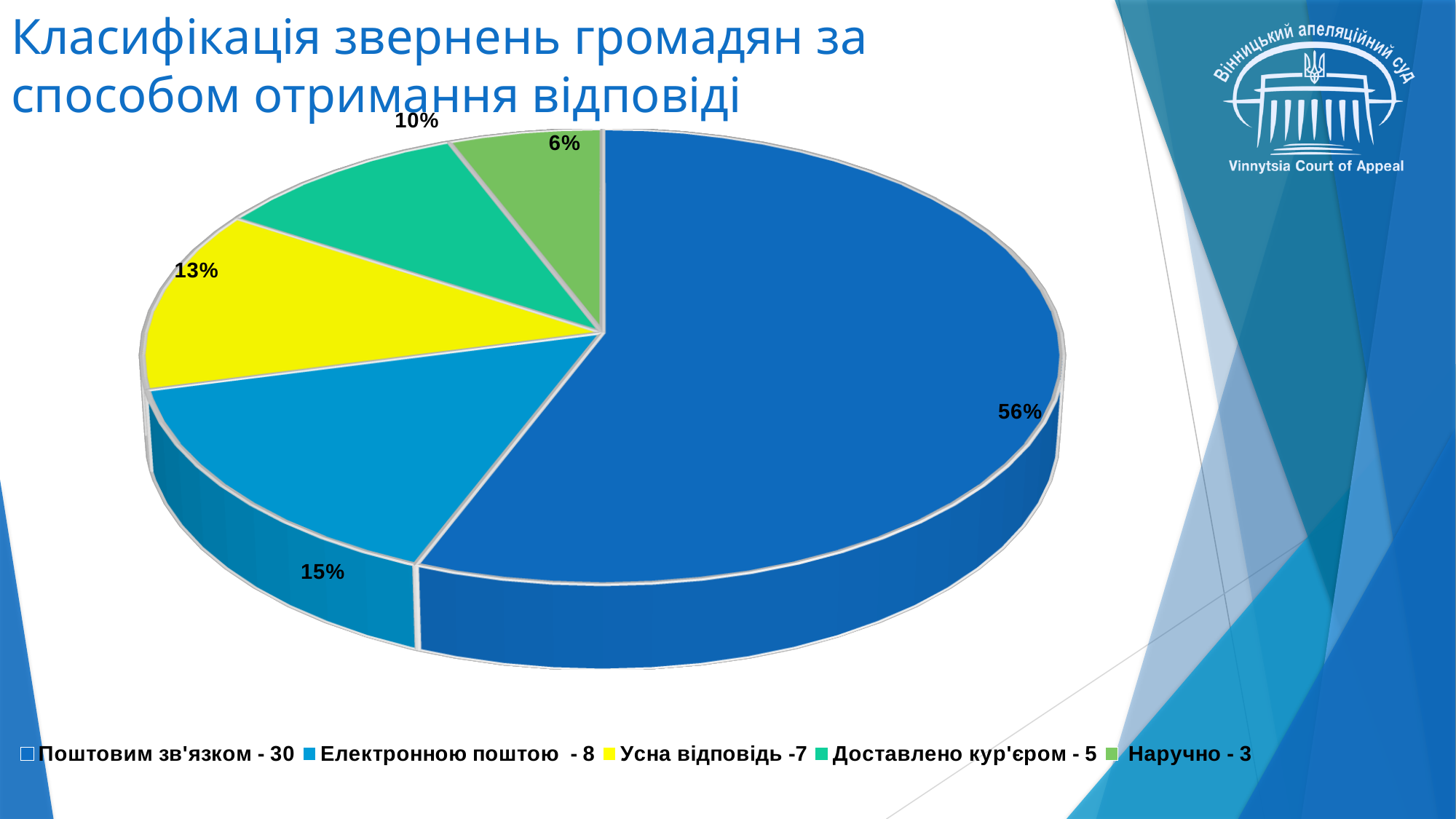
What percentage share is shown for the slice "Доставлено кур'єром"? 10% What percentage share is shown for the slice "Поштовим зв'язком"? 56% What kind of chart is shown on the slide? pie chart What is the difference in percentage points between the shares of "Поштовим зв'язком" and "Електронною поштою"? 41 What percentage share is shown for the slice "Наручно"? 6% Which category has the smallest share of the pie? Наручно Which has a larger share: "Усна відповідь" or "Доставлено кур'єром"? Усна відповідь How many slices does the pie chart have? 5 Which category has the largest share of the pie? Поштовим зв'язком What is the title of the chart on the slide? Класифікація звернень громадян за способом отримання відповіді